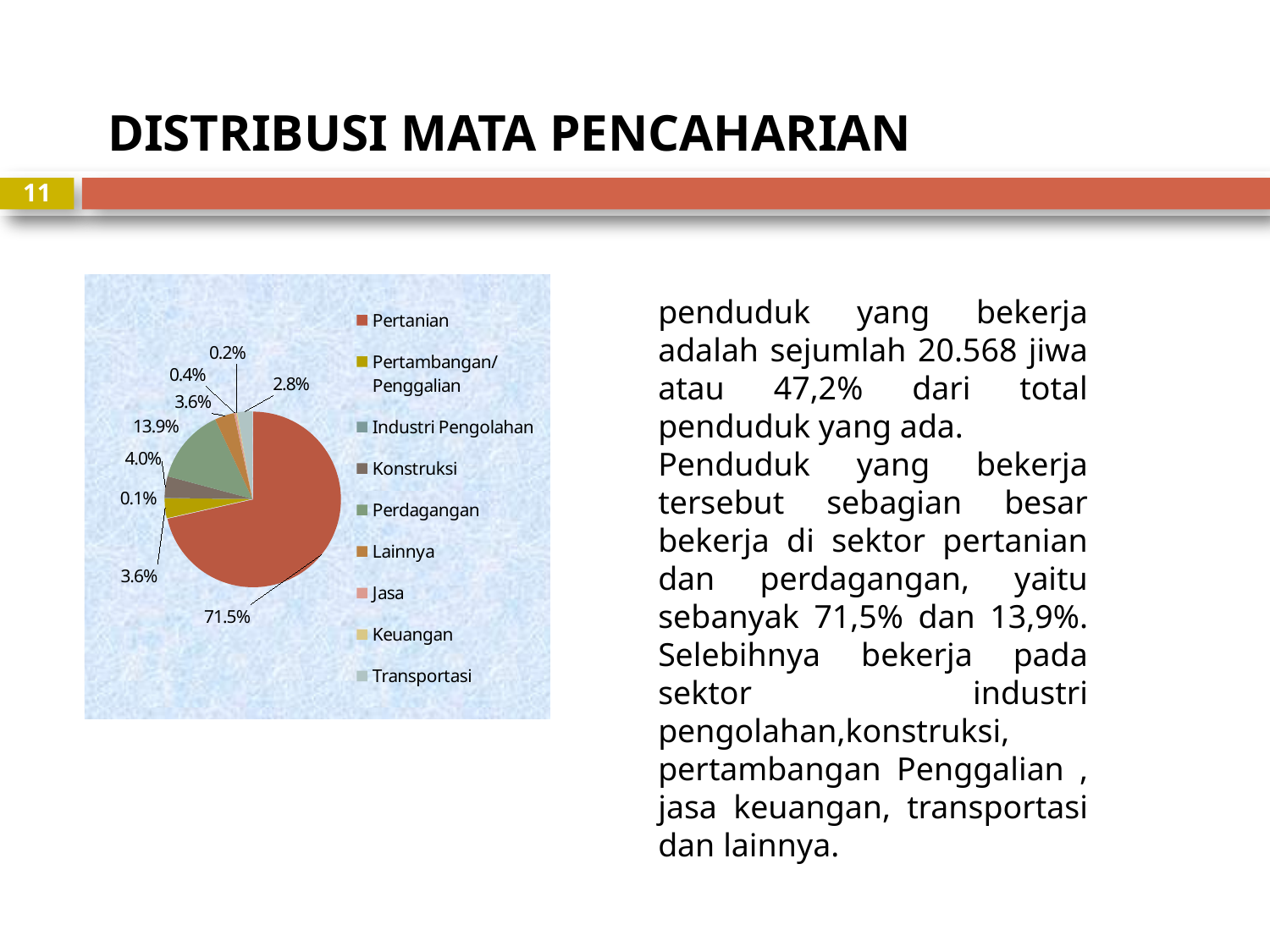
What percentage is shown for Transportasi? 2.8% Which is larger, the share for Pertanian or the share for Perdagangan? Pertanian What percentage of the pie does Perdagangan account for? 13.9% What percentage is shown for Konstruksi? 4.0% What type of chart is shown on the slide? Pie chart What percentage of the pie does Pertanian account for? 71.5% What is the title of the slide containing the pie chart? DISTRIBUSI MATA PENCAHARIAN What is the difference in percentage points between Pertanian and Perdagangan? 57.6 percentage points What colour is the Pertanian slice in the pie chart? Red Which category has the largest share of the pie? Pertanian How many categories does the legend of the pie chart list? 9 What is the smallest percentage label shown on the pie chart? 0.1%